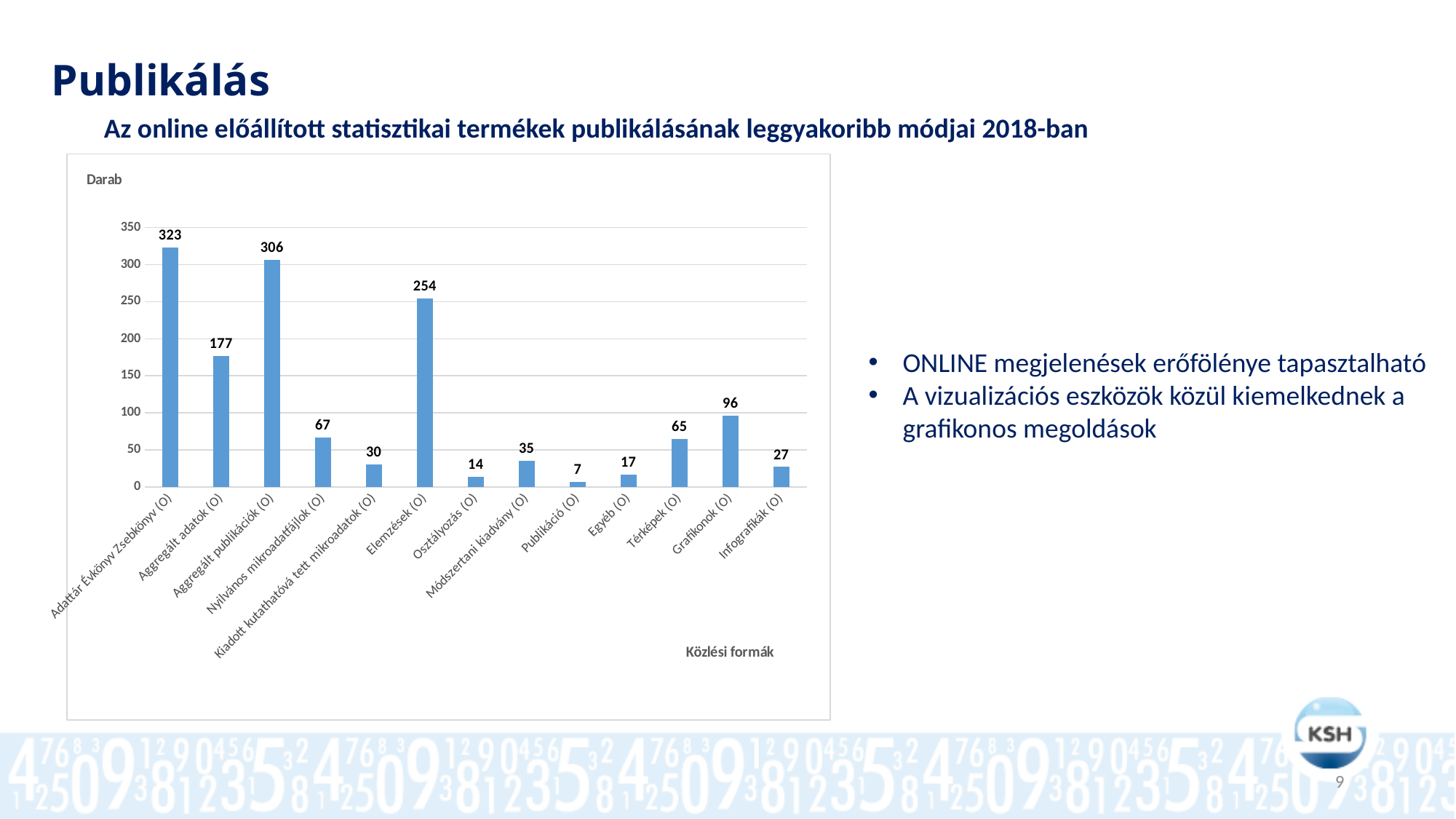
How many categories are shown on the x axis? 13 Which category has the lowest value? Publikáció (O) Which is larger, the value for Aggregált adatok (O) or the value for Elemzések (O)? Elemzések (O) What is the difference between the values for Grafikonok (O) and Térképek (O)? 31 What kind of chart is shown on the slide? bar chart What is the value for Elemzések (O)? 254 What is the value for Grafikonok (O)? 96 Which category has the highest value? Adattár Évkönyv Zsebkönyv (O) What is the difference between the values for Adattár Évkönyv Zsebkönyv (O) and Aggregált publikációk (O)? 17 Is the value for Nyilvános mikroadatfájlok (O) greater or less than 100? less What is the value for Adattár Évkönyv Zsebkönyv (O)? 323 What is the label of the vertical axis? Darab